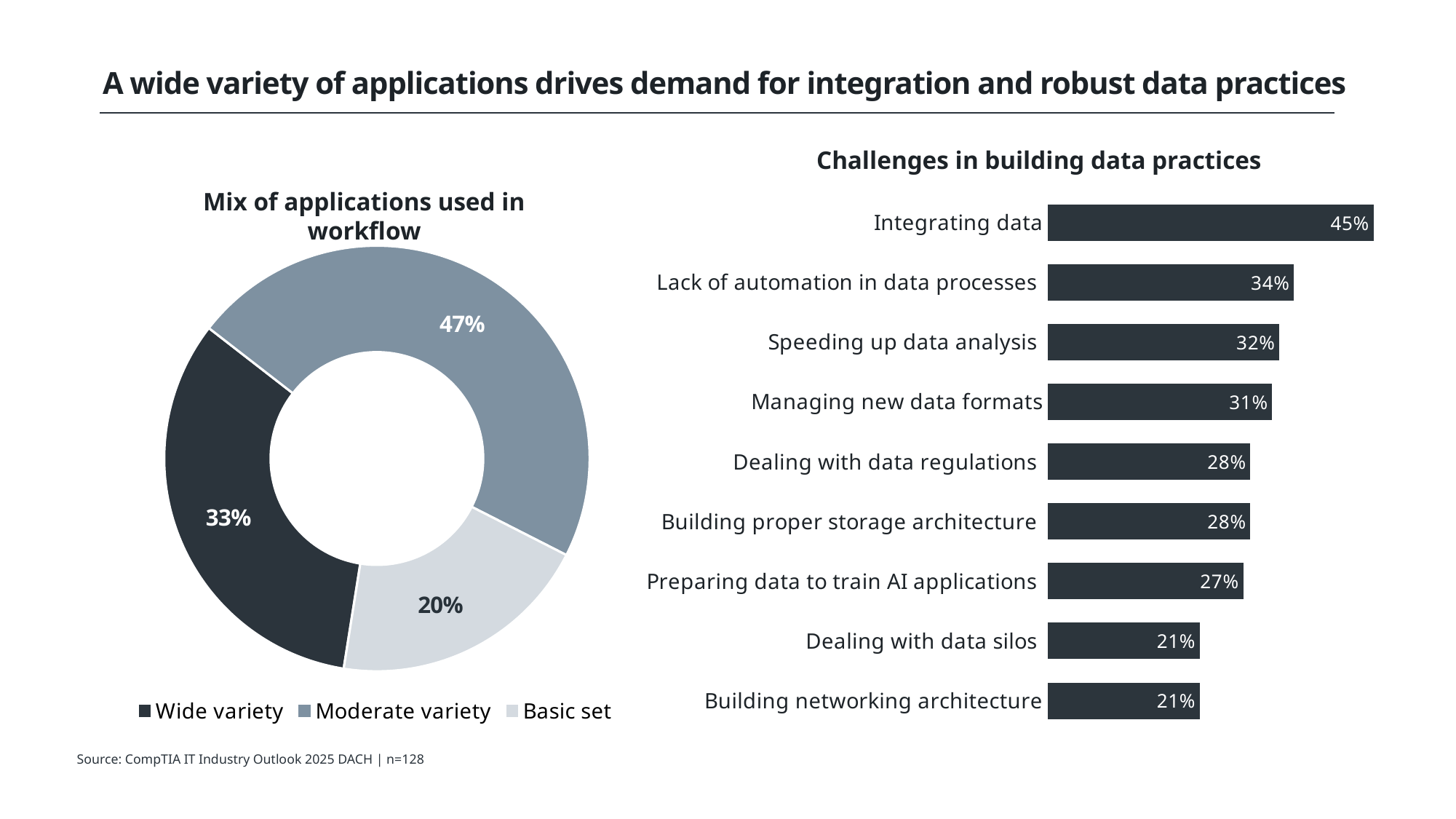
In the 'Challenges in building data practices' chart, what is the value for Integrating data? 45% In the 'Challenges in building data practices' chart, what is the difference between Integrating data and Lack of automation in data processes? 11% In the 'Mix of applications used in workflow' chart, how many categories does the legend list? 3 In the 'Challenges in building data practices' chart, which is larger: Speeding up data analysis or Preparing data to train AI applications? Speeding up data analysis What kind of chart is 'Mix of applications used in workflow'? Doughnut (pie) chart In the 'Challenges in building data practices' chart, which challenge has the highest value? Integrating data In the 'Challenges in building data practices' chart, what is the value for Managing new data formats? 31% In the 'Mix of applications used in workflow' chart, what share is labelled for Basic set? 20% In the 'Mix of applications used in workflow' chart, what is the difference between the Wide variety and Basic set shares? 13% In the 'Mix of applications used in workflow' chart, what share is labelled for Moderate variety? 47% In the 'Mix of applications used in workflow' chart, which category has the largest share? Moderate variety In the 'Challenges in building data practices' chart, how many challenges are listed? 9